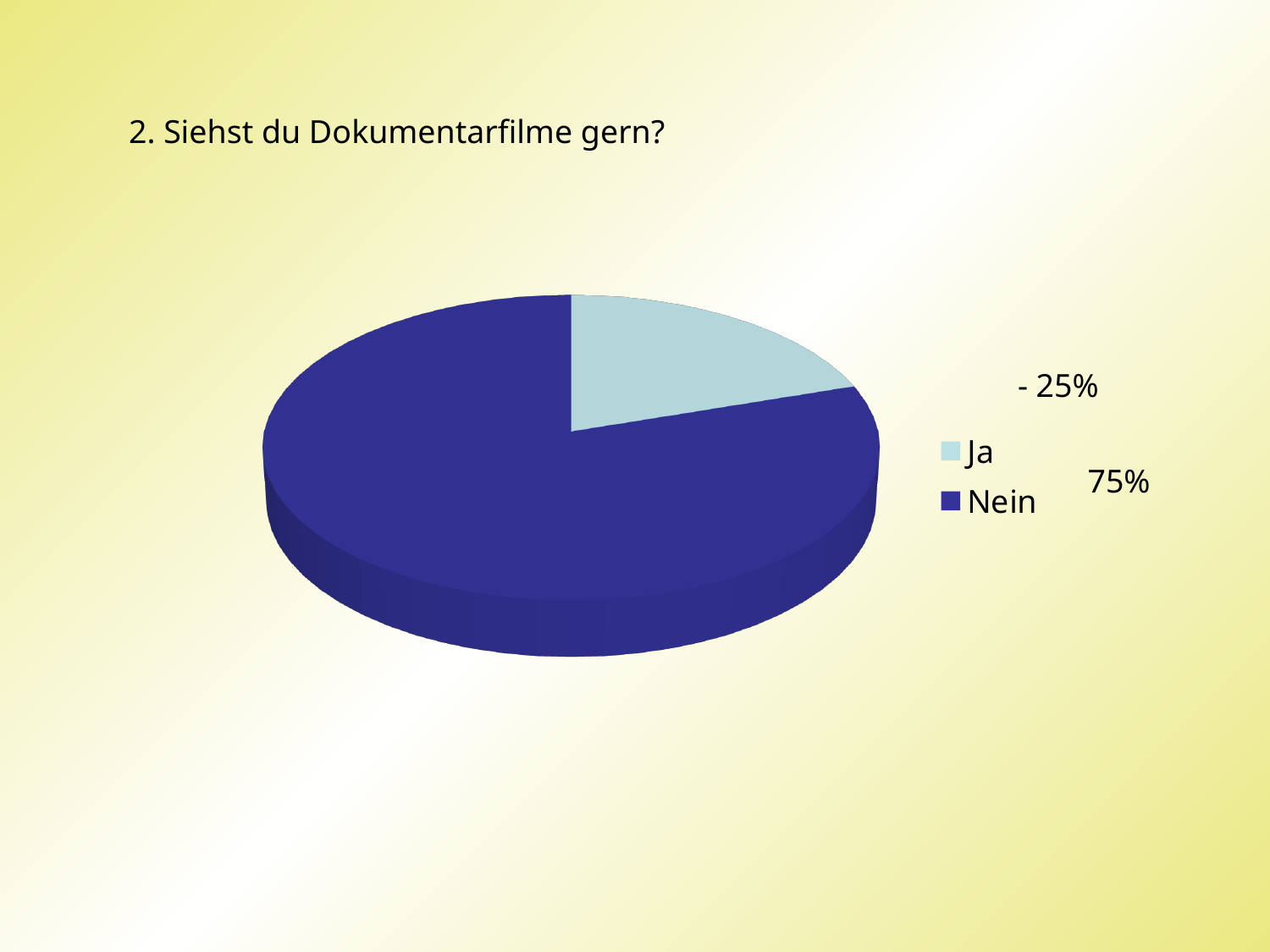
By how many percentage points does "Nein" exceed "Ja"? 50 Which is larger, the share for "Ja" or the share for "Nein"? Nein How many slices does the pie chart have? 2 What share of the pie does the "Nein" slice represent? 75% What kind of chart is shown on the slide? pie chart Which category has the smallest slice of the pie? Ja What is the title of the chart on the slide? 2. Siehst du Dokumentarfilme gern? Which category has the largest slice of the pie? Nein What percentage is shown for "Ja"? 25% How many entries does the legend list? 2 What colour is the "Nein" slice in the pie chart? dark blue What percentage is shown for "Nein"? 75%